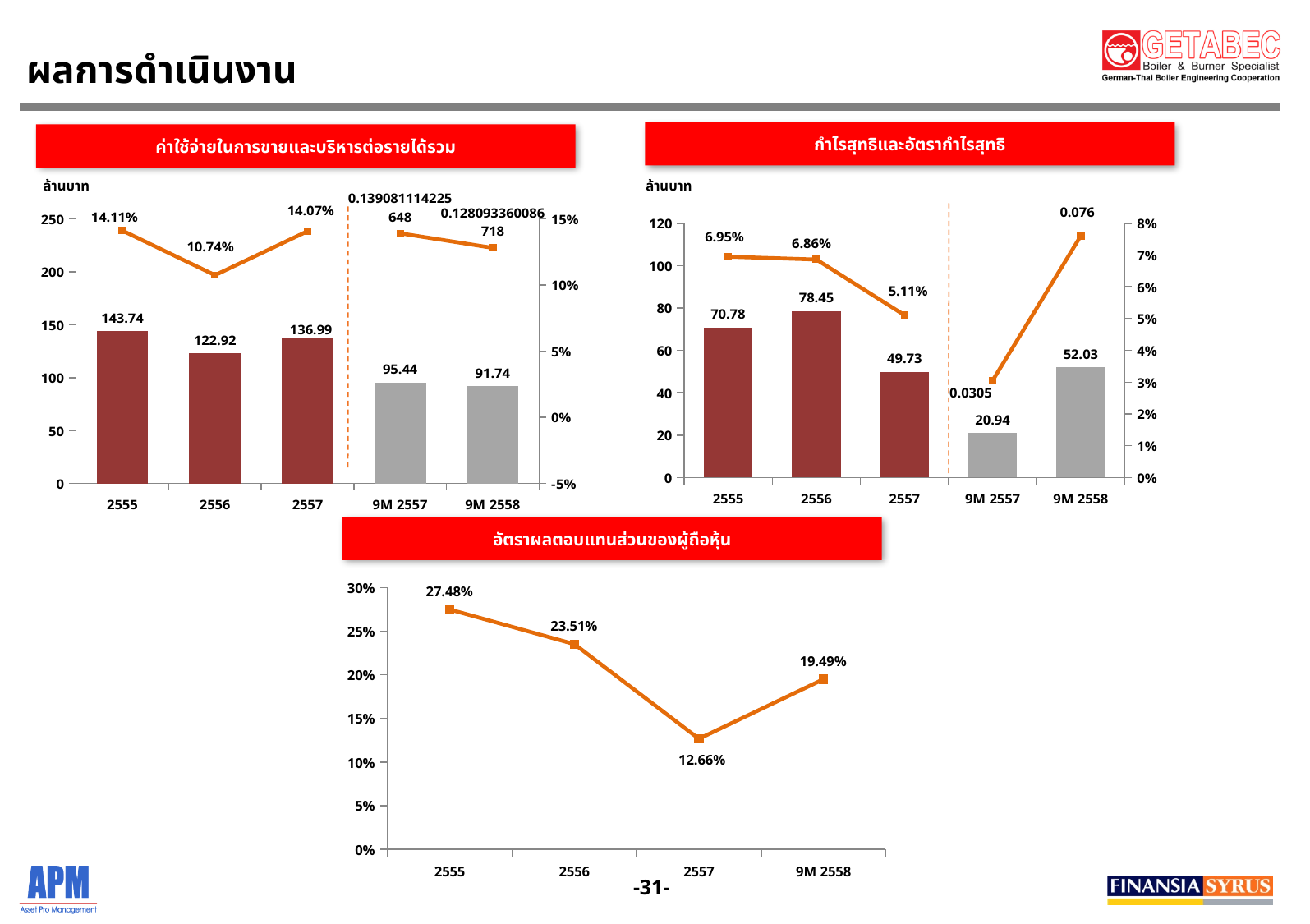
What kind of chart is the chart titled อัตราผลตอบแทนส่วนของผู้ถือหุ้น? Line chart In the chart titled กำไรสุทธิและอัตรากำไรสุทธิ, what is the bar value for 2556? 78.45 In the chart titled กำไรสุทธิและอัตรากำไรสุทธิ, what percentage is shown on the line for 2557? 5.11% In the chart titled กำไรสุทธิและอัตรากำไรสุทธิ, what is the difference between the bar values for 9M 2558 and 9M 2557? 31.09 In the chart titled กำไรสุทธิและอัตรากำไรสุทธิ, is the bar value for 2557 greater or less than 60? less In the chart titled อัตราผลตอบแทนส่วนของผู้ถือหุ้น, which category has the highest value? 2555 In the chart titled ค่าใช้จ่ายในการขายและบริหารต่อรายได้รวม, what is the bar value for 2555? 143.74 In the chart titled อัตราผลตอบแทนส่วนของผู้ถือหุ้น, what is the value for 2557? 12.66% In the chart titled กำไรสุทธิและอัตรากำไรสุทธิ, which category has the lowest bar value? 9M 2557 In the chart titled ค่าใช้จ่ายในการขายและบริหารต่อรายได้รวม, which year among 2555, 2556 and 2557 has the lowest bar value? 2556 In the chart titled ค่าใช้จ่ายในการขายและบริหารต่อรายได้รวม, what percentage is shown on the line for 2556? 10.74% In the chart titled ค่าใช้จ่ายในการขายและบริหารต่อรายได้รวม, what is the difference between the bar values for 9M 2557 and 9M 2558? 3.70